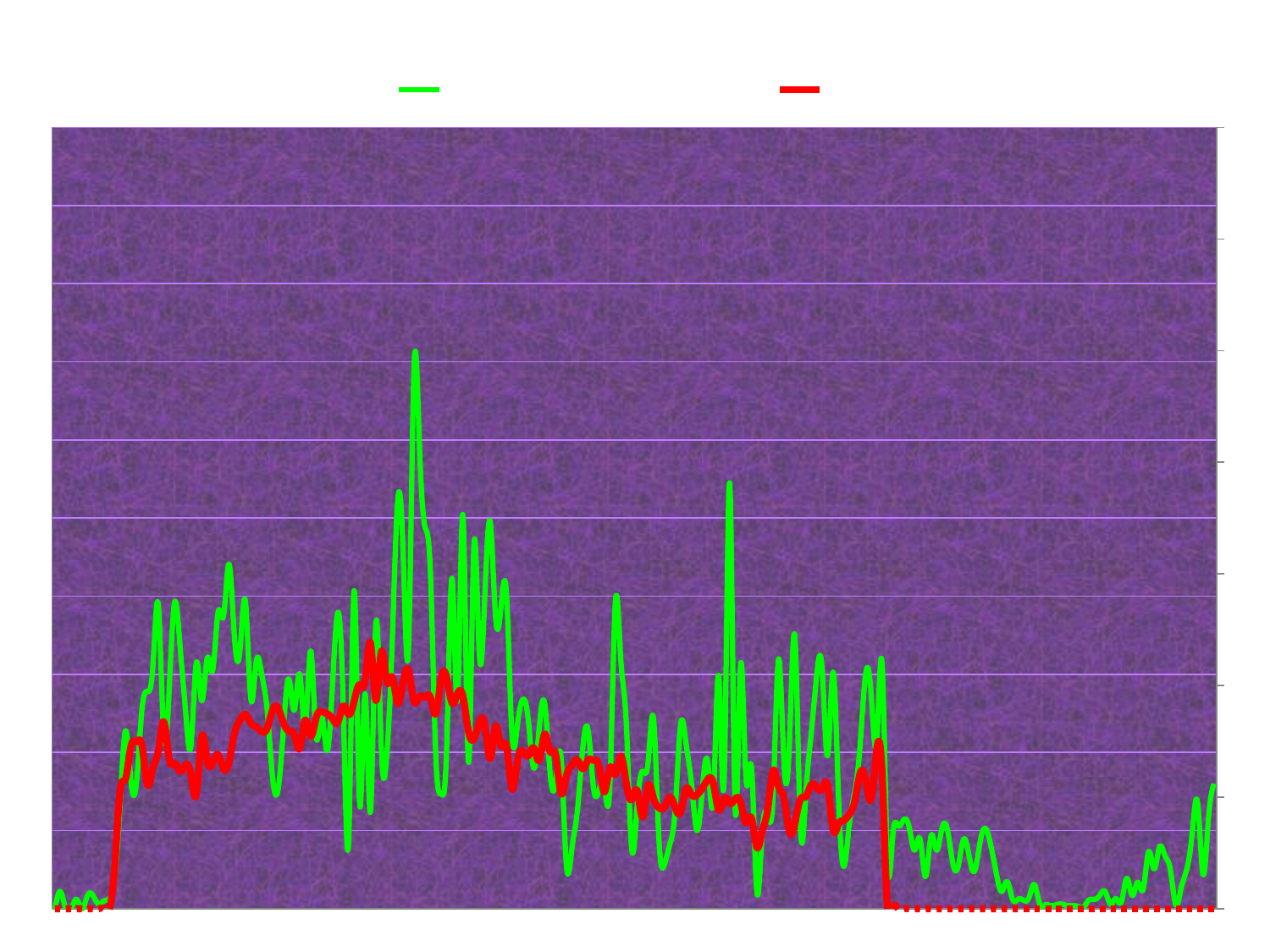
What colours are the two lines plotted in the chart? green and red Which line is smoother with fewer sharp spikes, the green line or the red line? red What kind of chart is shown on the slide? line chart Which line reaches a higher peak, the green line or the red line? green How many series does the legend list? 2